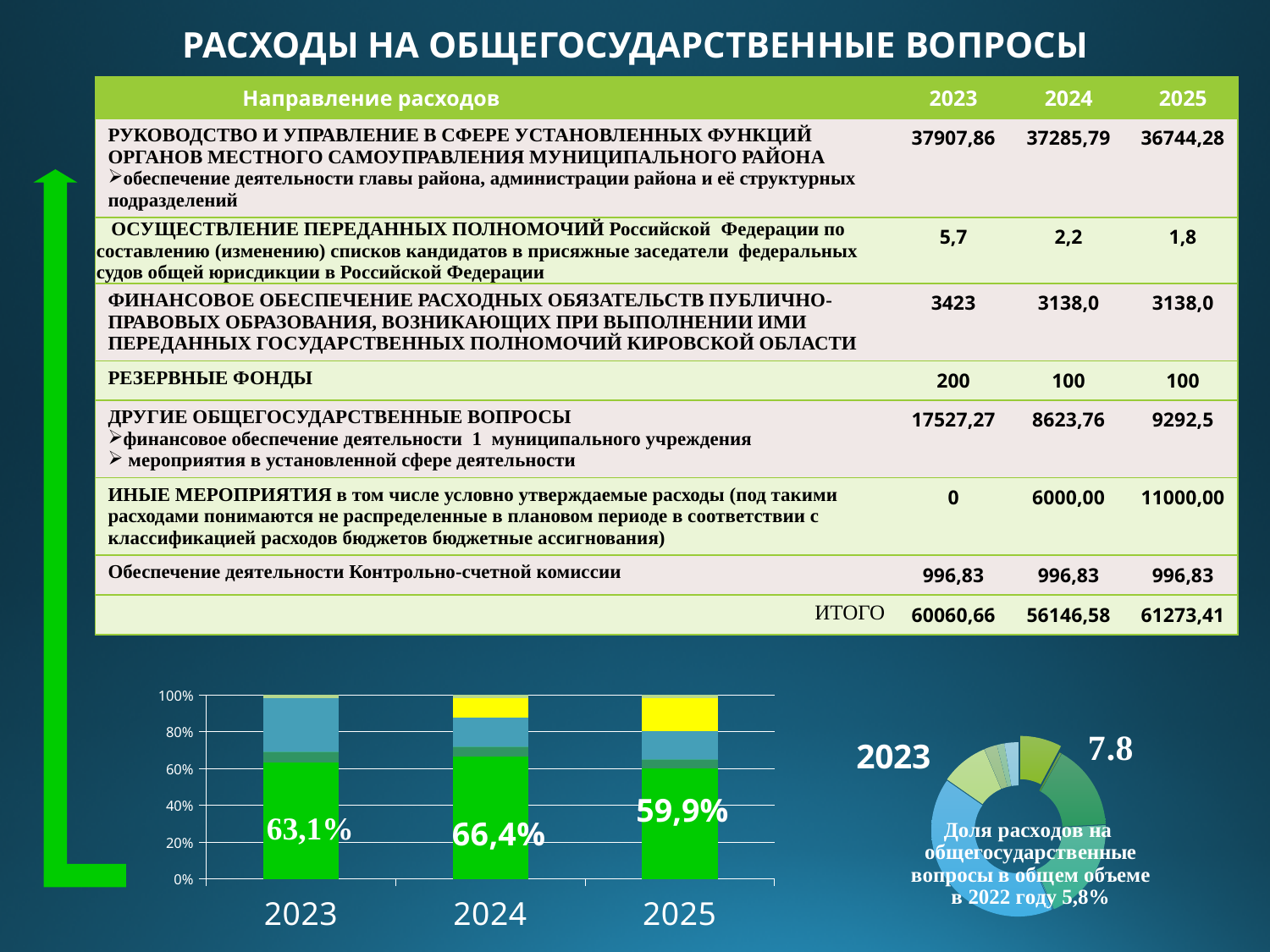
How many years (categories) are shown on the x axis of the stacked bar chart at the bottom left? 3 In the stacked bar chart at the bottom left, what is the labelled value of the green segment for 2025? 59,9% In the stacked bar chart at the bottom left, which year has the smallest labelled green segment? 2025 In the stacked bar chart at the bottom left, which year's bar has no yellow segment at the top? 2023 In the stacked bar chart at the bottom left, by how many percentage points does the green segment for 2024 exceed the green segment for 2025? 6,5 In the stacked bar chart at the bottom left, which year has the largest labelled green segment? 2024 What kind of chart is shown at the bottom left of the slide? Stacked bar chart What value is printed next to the doughnut chart at the bottom right, labelled 2023? 7.8 In the stacked bar chart at the bottom left, what is the labelled value of the green segment for 2024? 66,4% In the stacked bar chart at the bottom left, is the green segment larger for 2023 or for 2025? 2023 In the stacked bar chart at the bottom left, is the green segment for 2025 greater or less than 60%? less In the stacked bar chart at the bottom left, what is the labelled value of the green segment for 2023? 63,1%